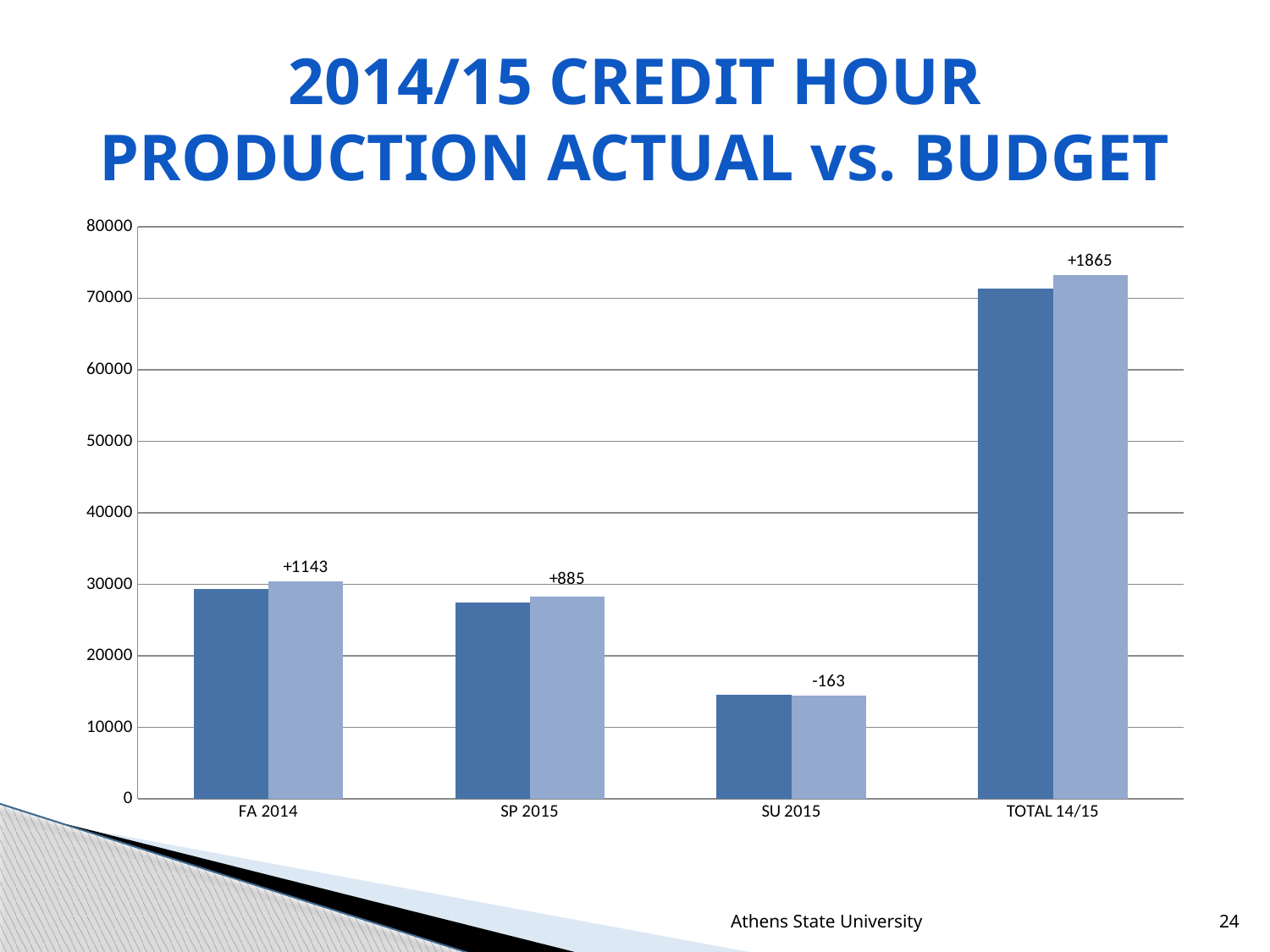
Are the bars for SU 2015 greater or less than 20000? less What kind of chart is shown on the slide? bar chart Which category has the tallest bars in the chart? TOTAL 14/15 How many categories are shown along the x axis of the chart? 4 What is the data label printed above the bars for TOTAL 14/15? +1865 What is the title of the slide containing the chart? 2014/15 CREDIT HOUR PRODUCTION ACTUAL vs. BUDGET Which category has the shortest bars in the chart? SU 2015 What is the data label printed above the bars for SP 2015? +885 How many bars are plotted for each category in the chart? 2 What is the data label printed above the bars for SU 2015? -163 What is the data label printed above the bars for FA 2014? +1143 Are the bars for TOTAL 14/15 greater or less than 70000? greater